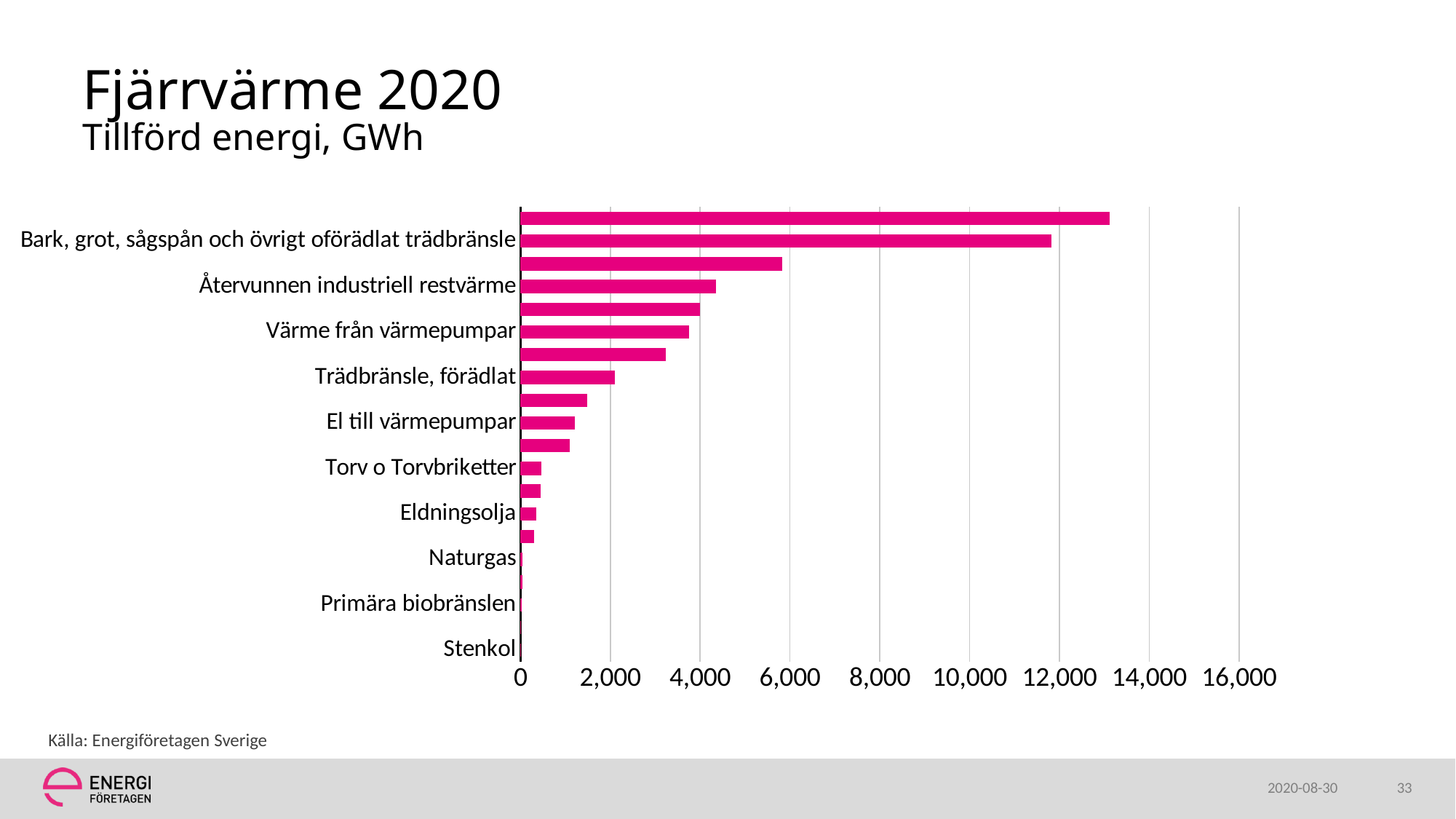
What kind of chart is shown on the slide? bar chart Is the value for Värme från värmepumpar greater or less than 2,000? greater Is the value for Bark, grot, sågspån och övrigt oförädlat trädbränsle greater or less than 10,000? greater Is the value for El till värmepumpar greater or less than 2,000? less How many category labels are shown on the vertical axis of the chart? 10 Which is larger, the value for El till värmepumpar or the value for Eldningsolja? El till värmepumpar Which is larger, the value for Bark, grot, sågspån och övrigt oförädlat trädbränsle or the value for Återvunnen industriell restvärme? Bark, grot, sågspån och övrigt oförädlat trädbränsle Which is larger, the value for Återvunnen industriell restvärme or the value for Trädbränsle, förädlat? Återvunnen industriell restvärme What unit is the supplied energy measured in, according to the chart subtitle? GWh